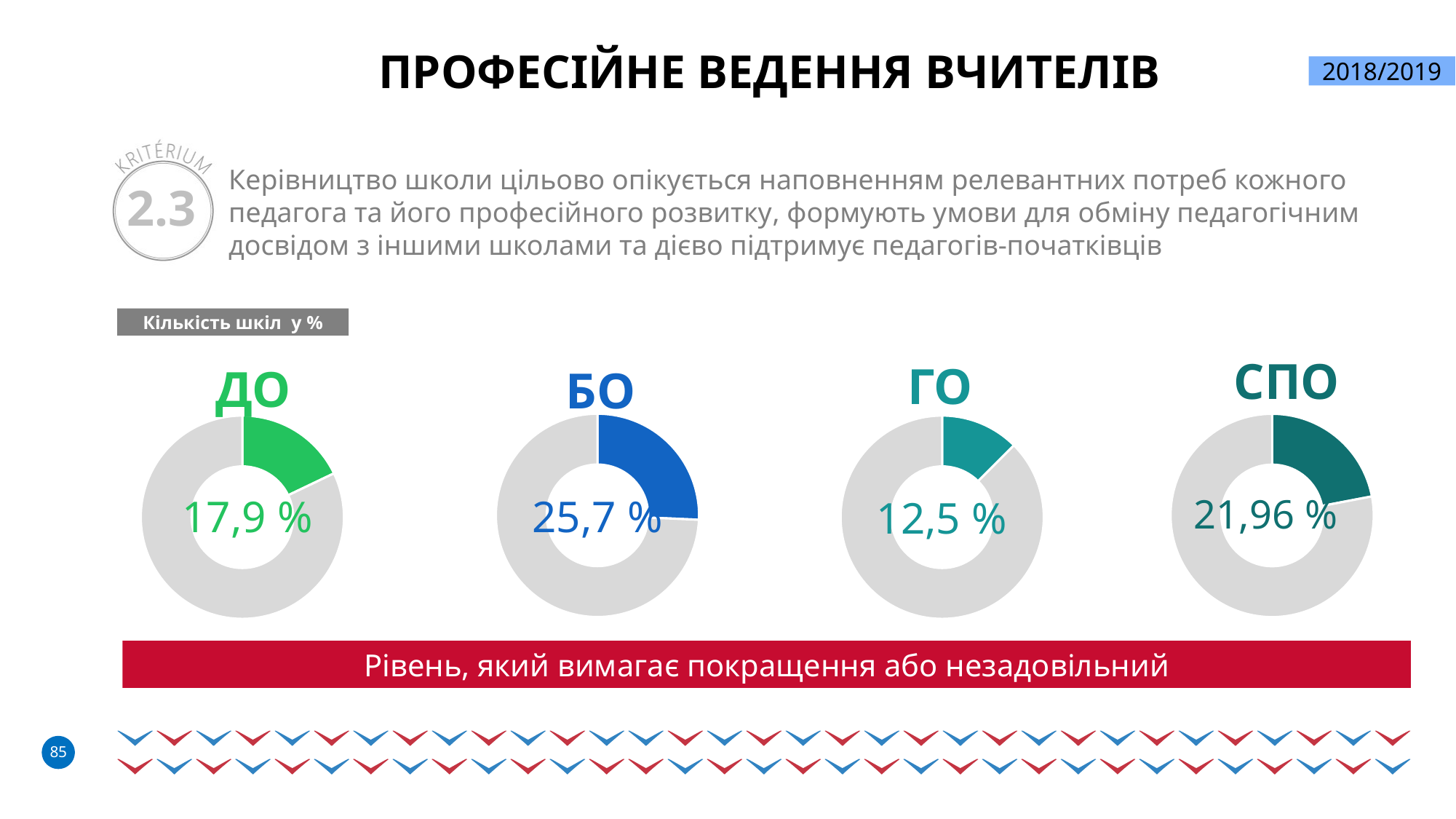
What is the difference between the СПО value and the ГО value? 9,46 % What does the grey label above the charts say the values represent? Кількість шкіл у % Which of the four donut charts (ДО, БО, ГО, СПО) shows the highest percentage? БО What value is shown in the ГО donut chart? 12,5 % What value is shown in the ДО donut chart? 17,9 % What is the difference between the БО value and the ДО value? 7,8 % Which is larger, the value for СПО or the value for ДО? СПО What type of chart is used to display the values for ДО, БО, ГО and СПО? Donut (pie) chart Which of the four donut charts (ДО, БО, ГО, СПО) shows the lowest percentage? ГО What value is shown in the БО donut chart? 25,7 % What value is shown in the СПО donut chart? 21,96 % How many donut charts are shown on the slide? 4